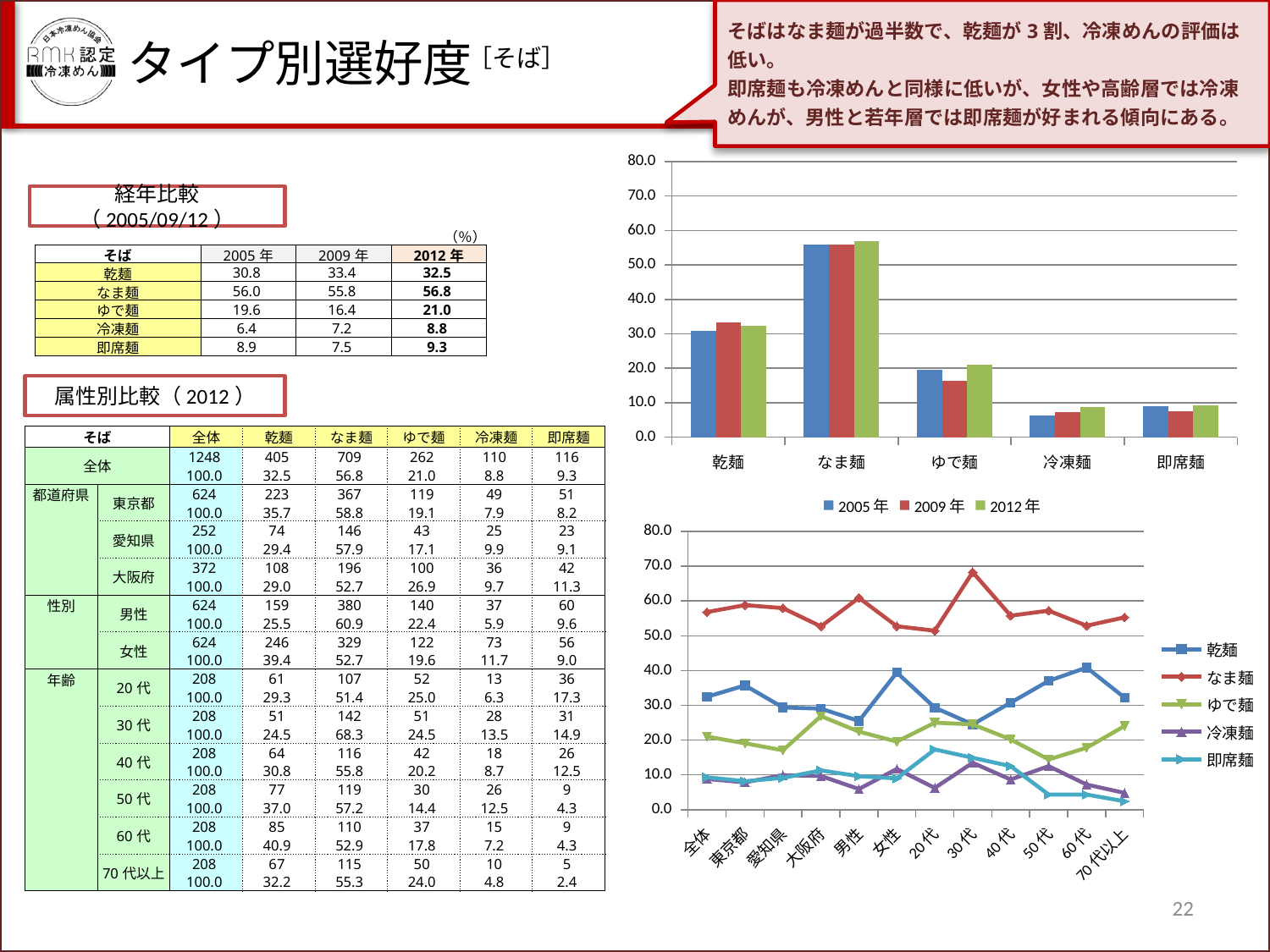
In the bottom-right line chart, how many categories are shown on the x axis? 12 What kind of chart is the bottom-right chart with categories from 全体 to 70代以上? line chart In the bottom-right line chart, is the value for 冷凍麺 at 男性 greater or less than 10? less In the top-right bar chart, is the value for なま麺 in 2012年 greater or less than 50? greater What kind of chart is the top-right chart comparing 乾麺, なま麺, ゆで麺, 冷凍麺 and 即席麺 by year? bar chart In the bottom-right line chart, which is larger at 20代: 即席麺 or 冷凍麺? 即席麺 In the top-right bar chart, which category has the highest value for 2012年? なま麺 In the top-right bar chart, is the value for ゆで麺 in 2009年 greater or less than 20? less In the top-right bar chart, which category has the lowest value for 2005年? 冷凍麺 In the top-right bar chart, how many series does the legend list? 3 In the top-right bar chart, which is larger for ゆで麺: the 2009年 value or the 2012年 value? 2012年 In the bottom-right line chart, at which category does the なま麺 line reach its highest value? 30代